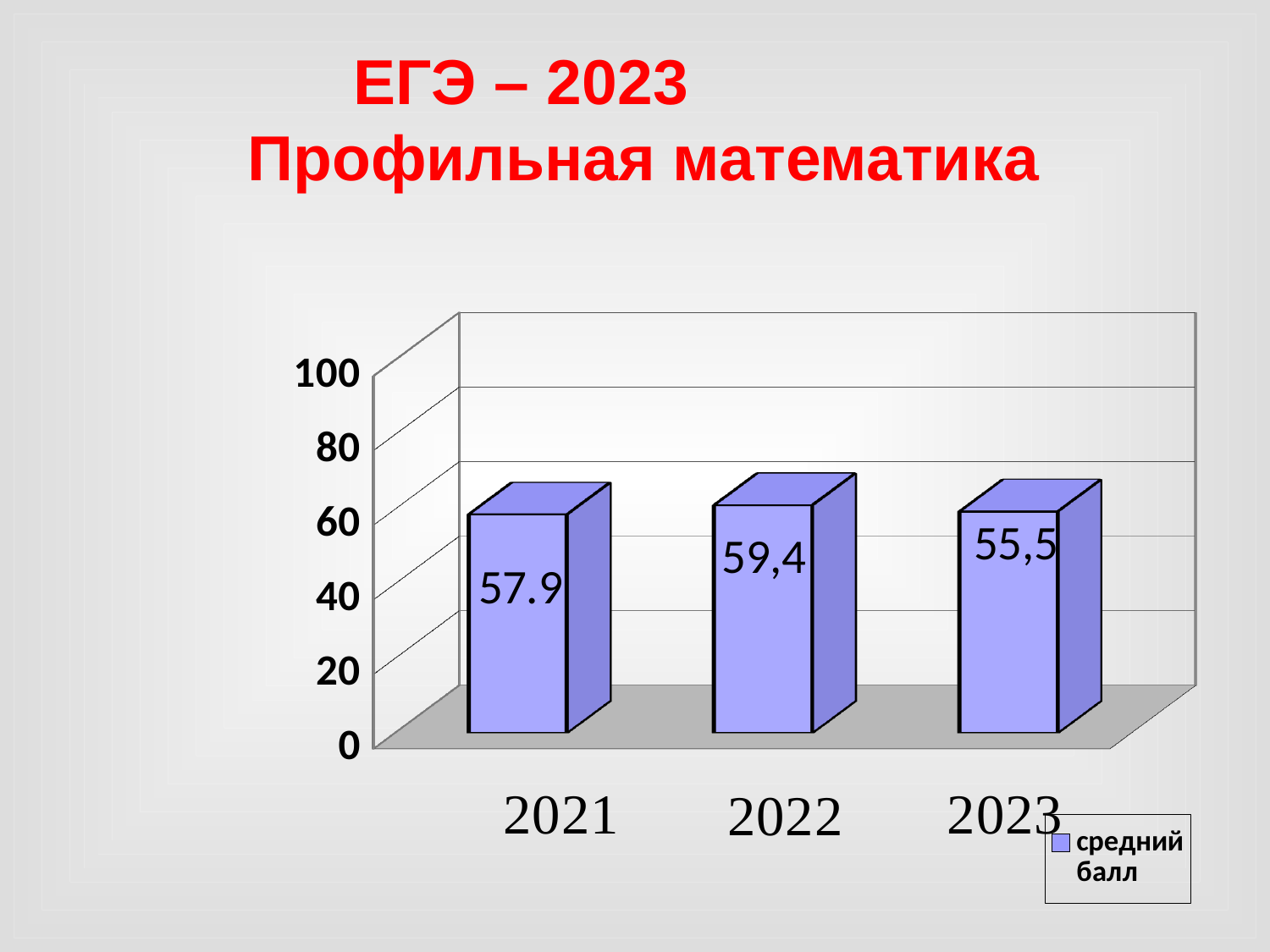
How many series does the legend list? 1 Does the average score rise or fall from 2022 to 2023? fall Which is larger, the average score for 2021 or for 2023? 2021 Which year has the lowest average score? 2023 What kind of chart is shown on the slide? bar chart Which year has the highest average score? 2022 What is the average score (средний балл) shown for 2021? 57.9 What is the average score shown for 2022? 59,4 How many years are shown on the x axis? 3 What is the difference between the average scores for 2022 and 2023? 3,9 Is the value for 2022 greater or less than 80? less What is the average score shown for 2023? 55,5